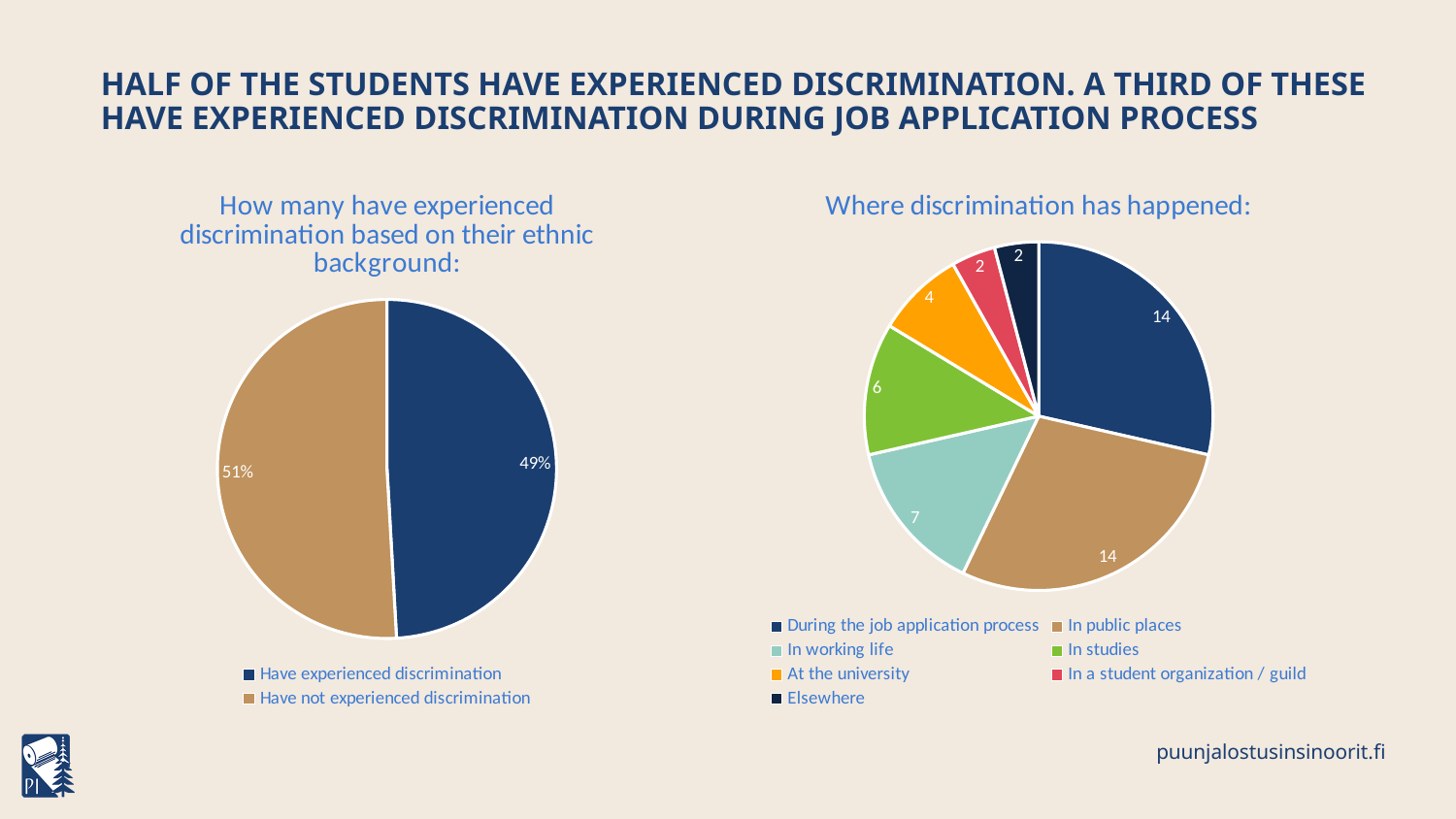
In the 'Where discrimination has happened' chart, what is the sum of all the slice values? 49 In the left chart, what percentage of students have experienced discrimination? 49% In the 'Where discrimination has happened' chart, what is the value for 'In studies'? 6 In the 'Where discrimination has happened' chart, what is the value for 'In working life'? 7 In the left chart, which category has the larger share: 'Have experienced discrimination' or 'Have not experienced discrimination'? Have not experienced discrimination How many categories does the legend of the 'Where discrimination has happened' chart list? 7 In the left chart, what percentage of students have not experienced discrimination? 51% In the 'Where discrimination has happened' chart, what is the difference between the values for 'In working life' and 'In studies'? 1 In the 'Where discrimination has happened' chart, which is larger: 'In public places' or 'At the university'? In public places In the 'Where discrimination has happened' chart, what is the value for 'During the job application process'? 14 What kind of chart is the 'Where discrimination has happened' chart? Pie chart In the 'Where discrimination has happened' chart, what is the value for 'At the university'? 4